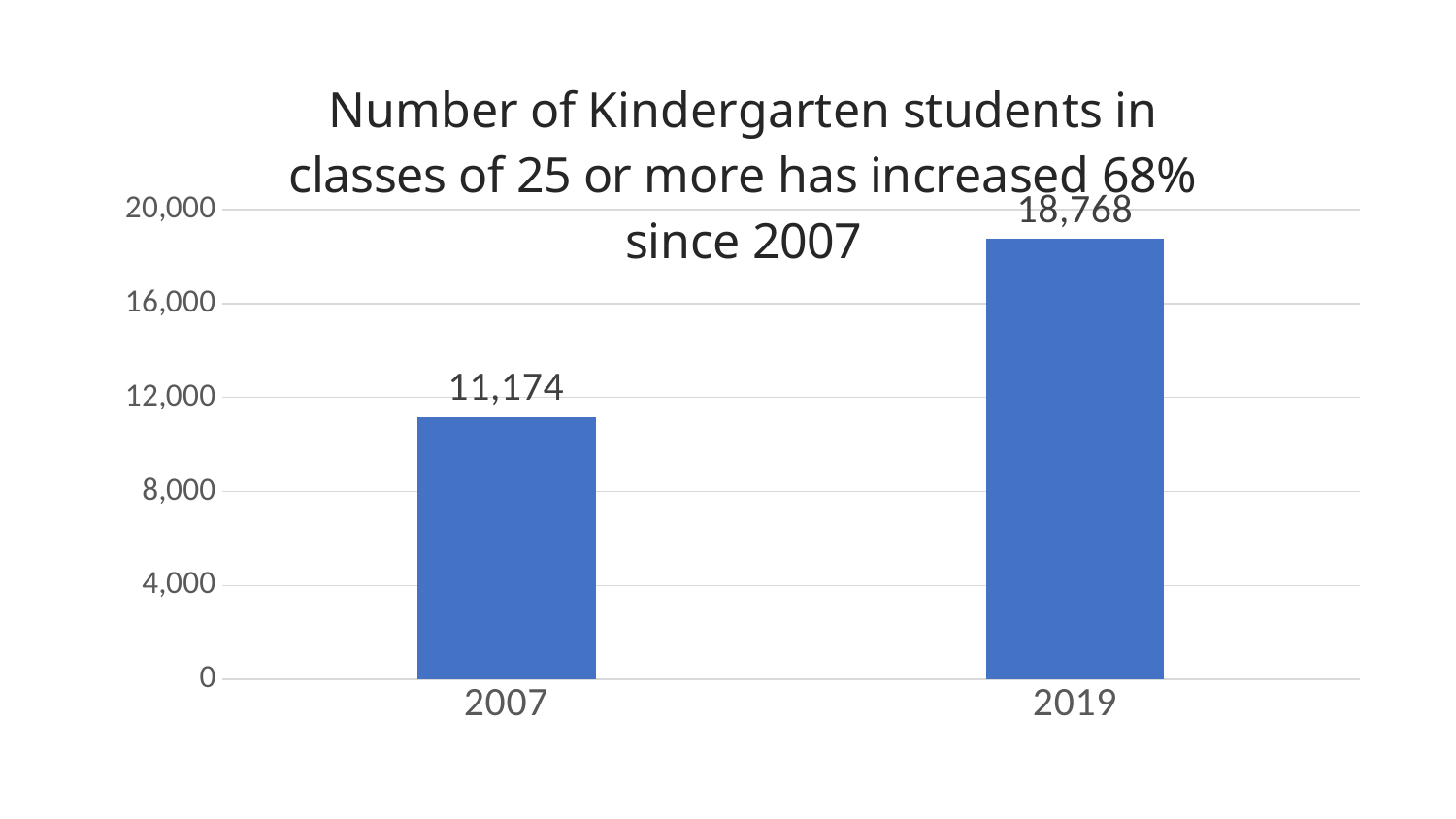
Is the value for 2007 greater or less than 12,000? less According to the chart title, by what percentage has the number of Kindergarten students in classes of 25 or more increased since 2007? 68% Is the value for 2019 greater or less than 16,000? greater What is the value for 2007? 11,174 Is the value for 2019 larger than the value for 2007? Yes Which year has the lower value? 2007 Which year has the higher value? 2019 What is the difference between the values for 2019 and 2007? 7,594 How many bars are shown in the chart? 2 What kind of chart is this? Bar chart What is the value for 2019? 18,768 Do the values rise or fall from 2007 to 2019? Rise